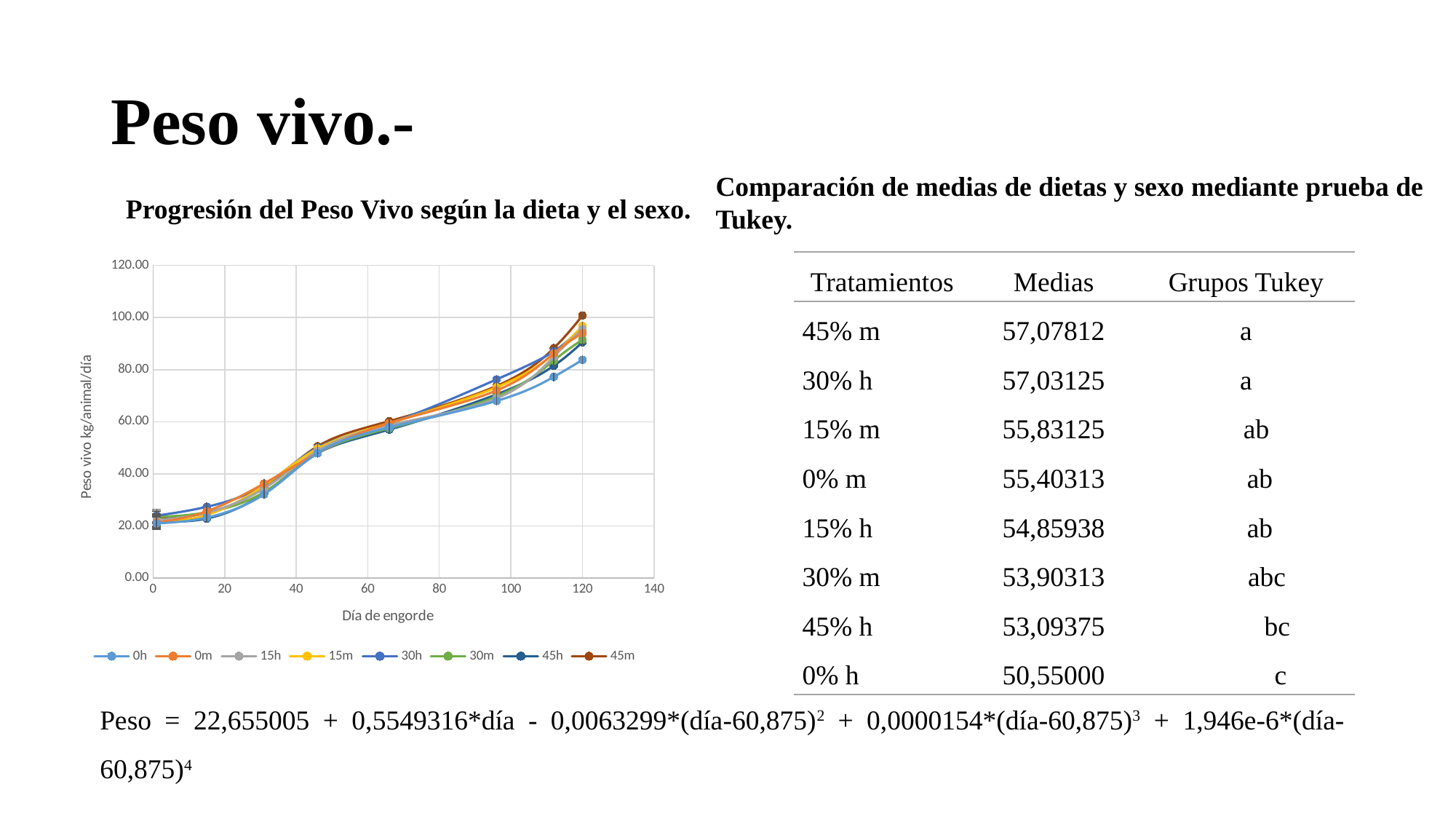
Is the value for 45m at day 120 greater or less than 80? greater Which series has the lowest value at day 120? 0h What kind of chart is shown on the slide? line chart Is the value for 0h at day 120 greater or less than 100? less How many series does the chart legend list? 8 At day 120, which series has the larger value, 45m or 0h? 45m Is the value for 30h at day 66 greater or less than 80? less Which series has the highest value at day 120? 45m Do the values in the chart rise or fall as the day of fattening increases? rise What is the label of the x axis of the chart? Día de engorde What is the title of the chart? Progresión del Peso Vivo según la dieta y el sexo.